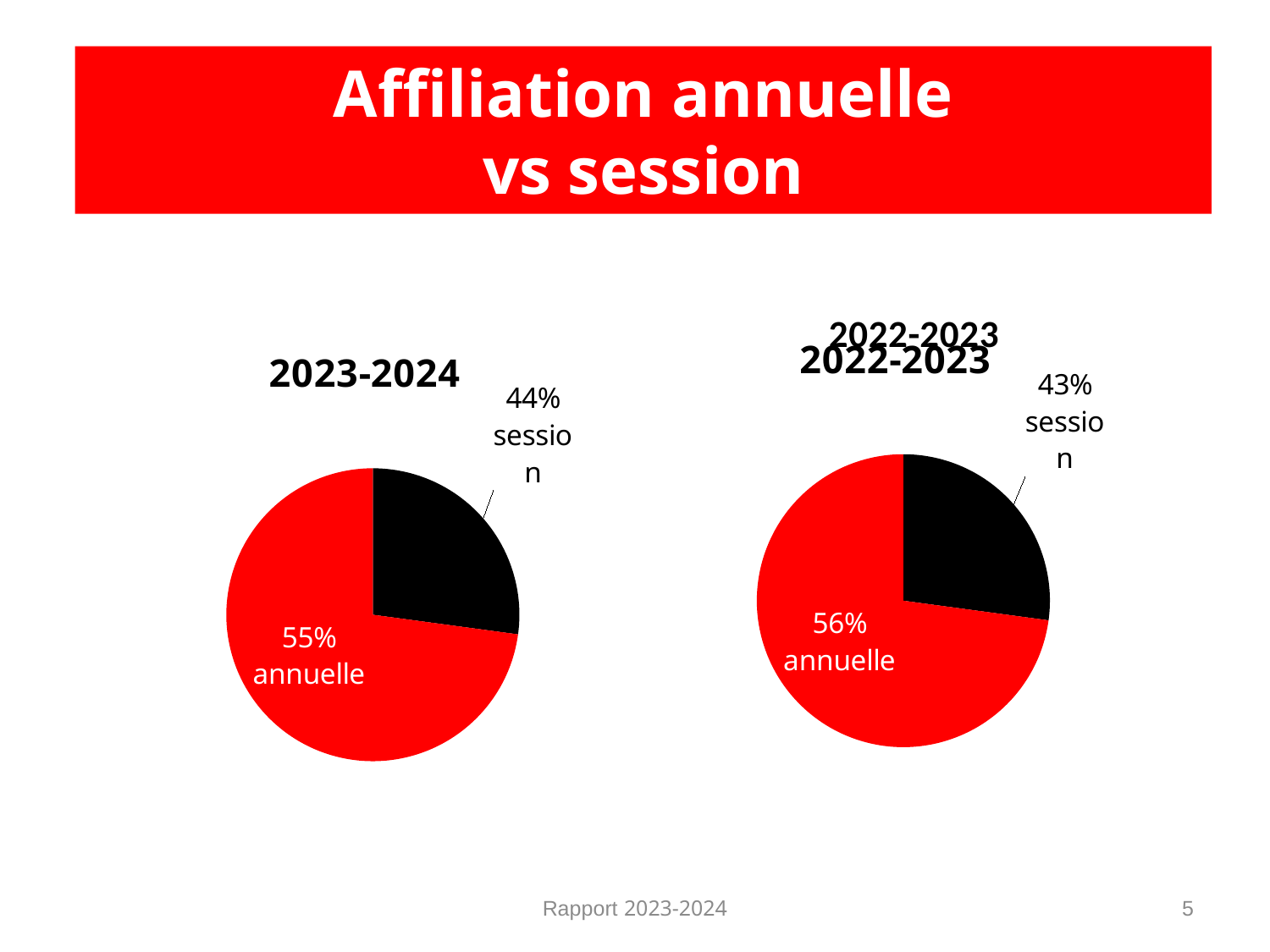
In the 2022-2023 chart, what is the difference between the annuelle and session shares? 13% In the 2022-2023 chart, which slice is the smallest? session In the 2023-2024 chart, what share of the pie is labelled session? 44% In the 2022-2023 chart, what share of the pie is labelled session? 43% In the 2023-2024 chart, what share of the pie is labelled annuelle? 55% In the 2023-2024 chart, what is the difference between the annuelle and session shares? 11% In the 2023-2024 chart, what colour is the annuelle slice? red How many slices does the 2022-2023 pie chart have? 2 What kind of chart is the 2023-2024 chart? pie chart In the 2023-2024 chart, which slice is the largest? annuelle In the 2023-2024 chart, which is larger, annuelle or session? annuelle